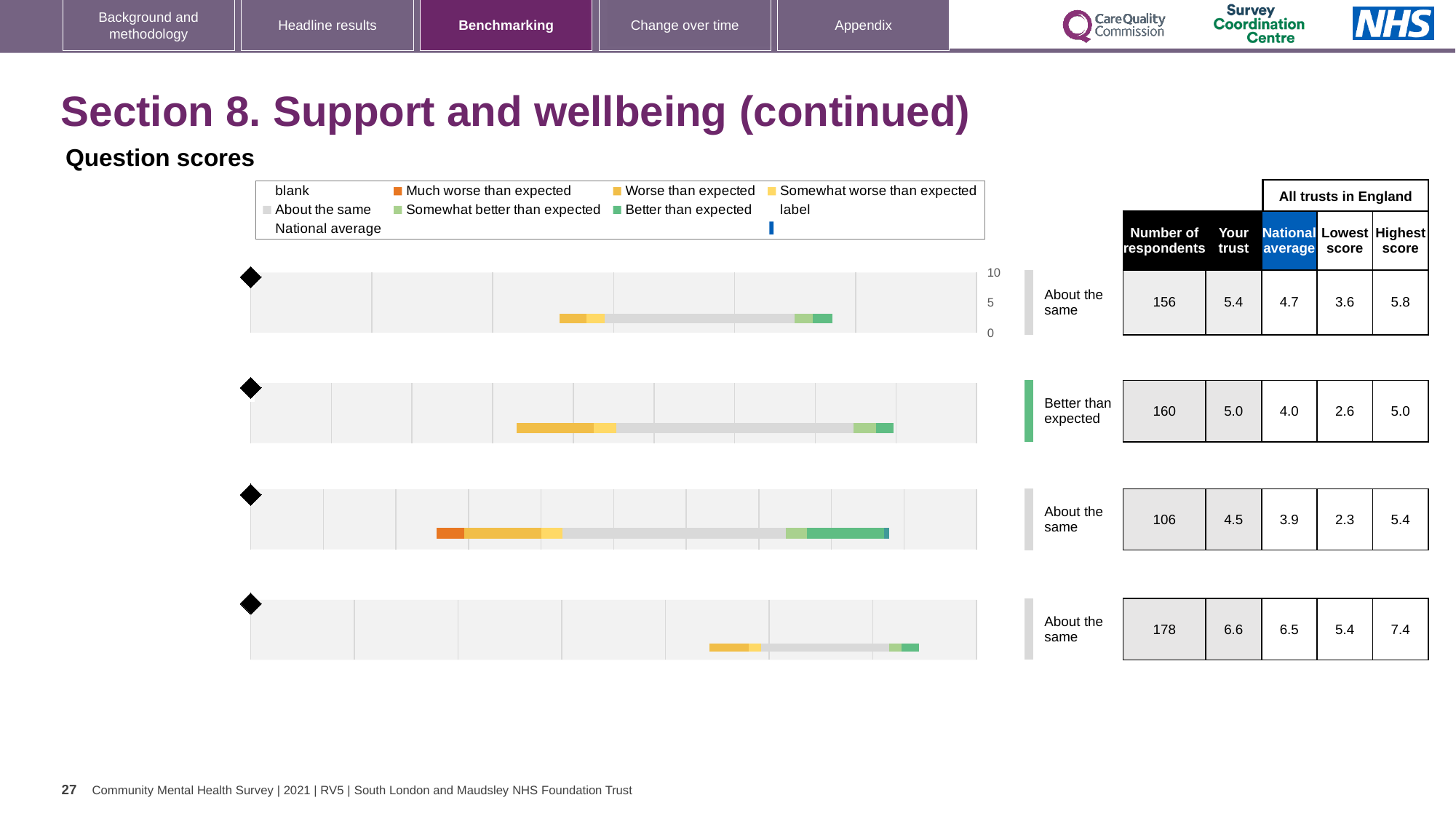
For the third chart from the top, what is the difference between the 'Your trust' score and the national average? 0.6 For the second chart from the top, what is the national average score? 4.0 For the fourth chart from the top, what is the highest score among all trusts in England? 7.4 For the first chart from the top, what is the lowest score among all trusts in England? 3.6 Which chart has the lowest number of respondents? the third chart from the top (106) For the first chart from the top, what is the 'Your trust' score shown in the table? 5.4 Which chart is rated 'Better than expected'? the second chart from the top Which chart has the highest 'Your trust' score? the fourth chart from the top (6.6) For the second chart from the top, which is larger: the 'Your trust' score or the national average? Your trust (5.0) How many charts are shown on the slide? 4 What kind of chart is the first chart from the top? bar chart For the third chart from the top, what is the number of respondents? 106